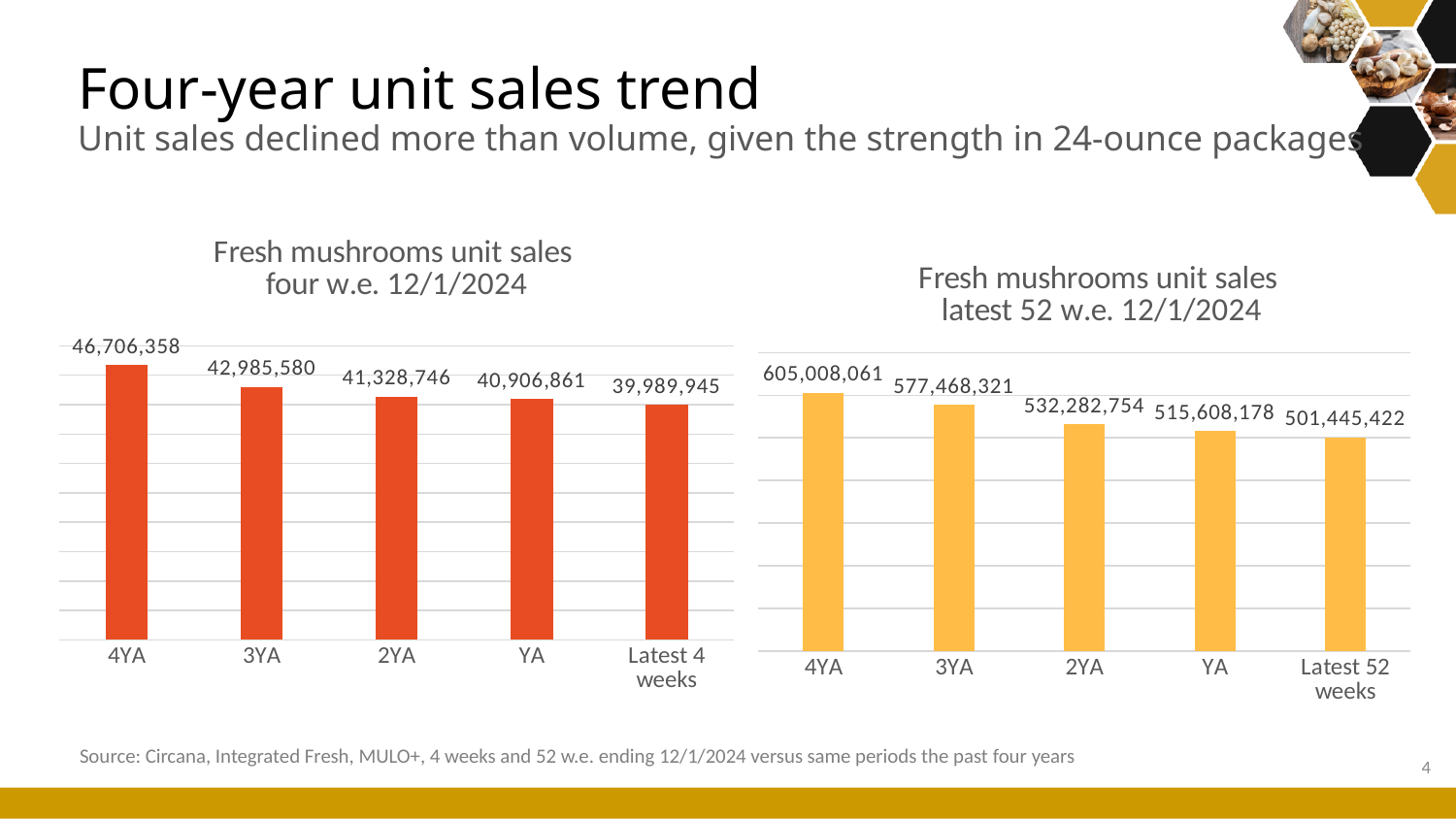
How many periods are shown on the x axis of the 'Fresh mushrooms unit sales four w.e. 12/1/2024' chart? 5 What kind of chart is the 'Fresh mushrooms unit sales latest 52 w.e. 12/1/2024' chart? Bar chart In the 'Fresh mushrooms unit sales four w.e. 12/1/2024' chart, which period has the highest value? 4YA In the 'Fresh mushrooms unit sales four w.e. 12/1/2024' chart, what is the value for the Latest 4 weeks? 39,989,945 In the 'Fresh mushrooms unit sales latest 52 w.e. 12/1/2024' chart, which period has the lowest value? Latest 52 weeks In the 'Fresh mushrooms unit sales latest 52 w.e. 12/1/2024' chart, do the values rise or fall from 4YA to Latest 52 weeks? Fall In the 'Fresh mushrooms unit sales four w.e. 12/1/2024' chart, what is the value for 4YA? 46,706,358 In the 'Fresh mushrooms unit sales latest 52 w.e. 12/1/2024' chart, what is the difference between the 3YA value and the 2YA value? 45,185,567 In the 'Fresh mushrooms unit sales latest 52 w.e. 12/1/2024' chart, which is larger, the value for 3YA or the value for YA? 3YA In the 'Fresh mushrooms unit sales latest 52 w.e. 12/1/2024' chart, what is the value for 2YA? 532,282,754 In the 'Fresh mushrooms unit sales four w.e. 12/1/2024' chart, what is the difference between the 4YA value and the Latest 4 weeks value? 6,716,413 In the 'Fresh mushrooms unit sales latest 52 w.e. 12/1/2024' chart, what is the value for YA? 515,608,178